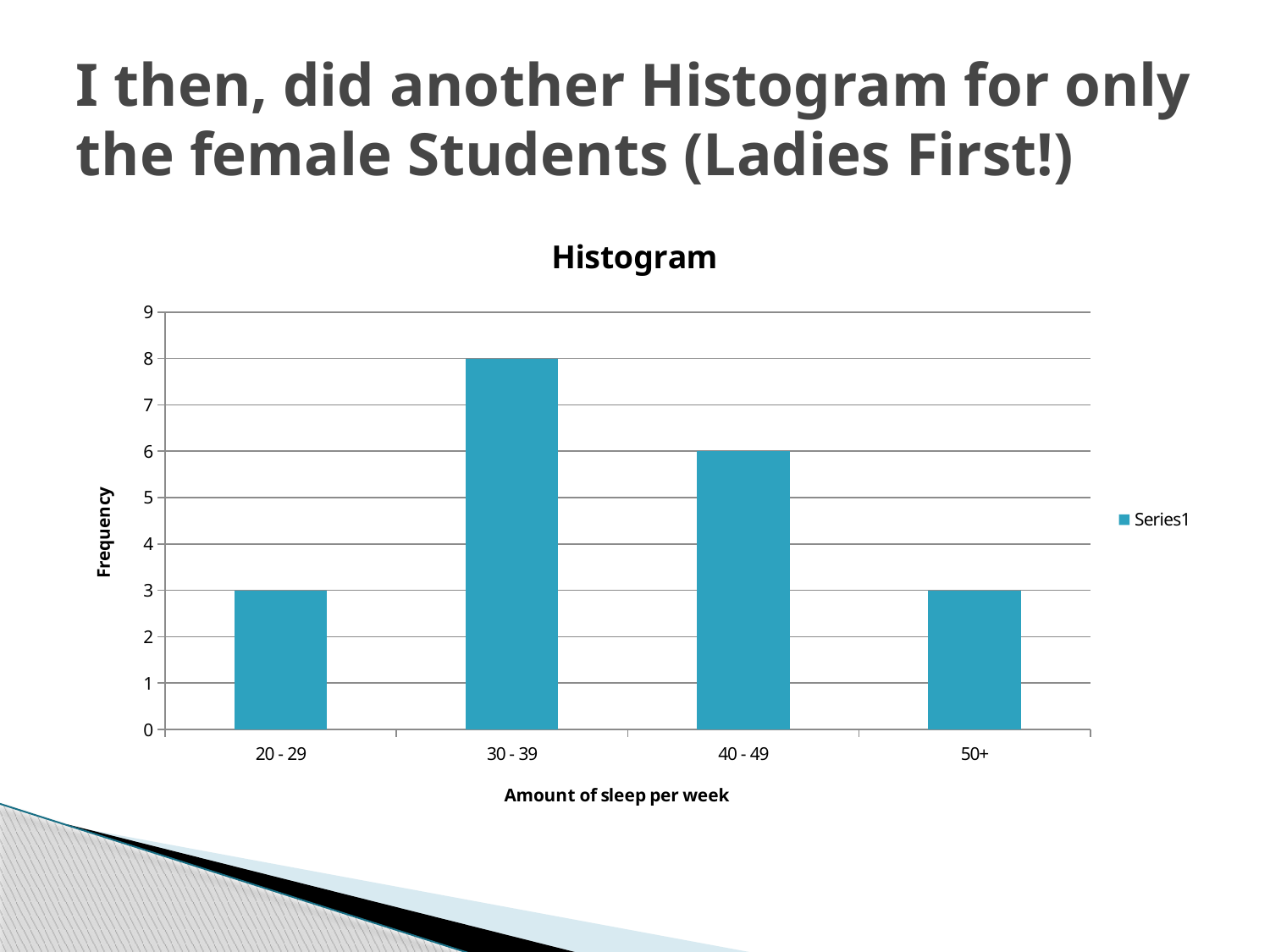
What is the frequency for the 30 - 39 category? 8 Which has a higher frequency, 40 - 49 or 50+? 40 - 49 What is the frequency for the 40 - 49 category? 6 What kind of chart is shown on the slide? bar chart What is the difference in frequency between the 30 - 39 and 20 - 29 categories? 5 How many series does the legend list? 1 What is the frequency for the 20 - 29 category? 3 What is the frequency for the 50+ category? 3 How many categories are shown on the x axis? 4 What is the difference in frequency between the 30 - 39 and 40 - 49 categories? 2 Is the frequency for 30 - 39 greater or less than 5? greater Which category has the highest frequency? 30 - 39